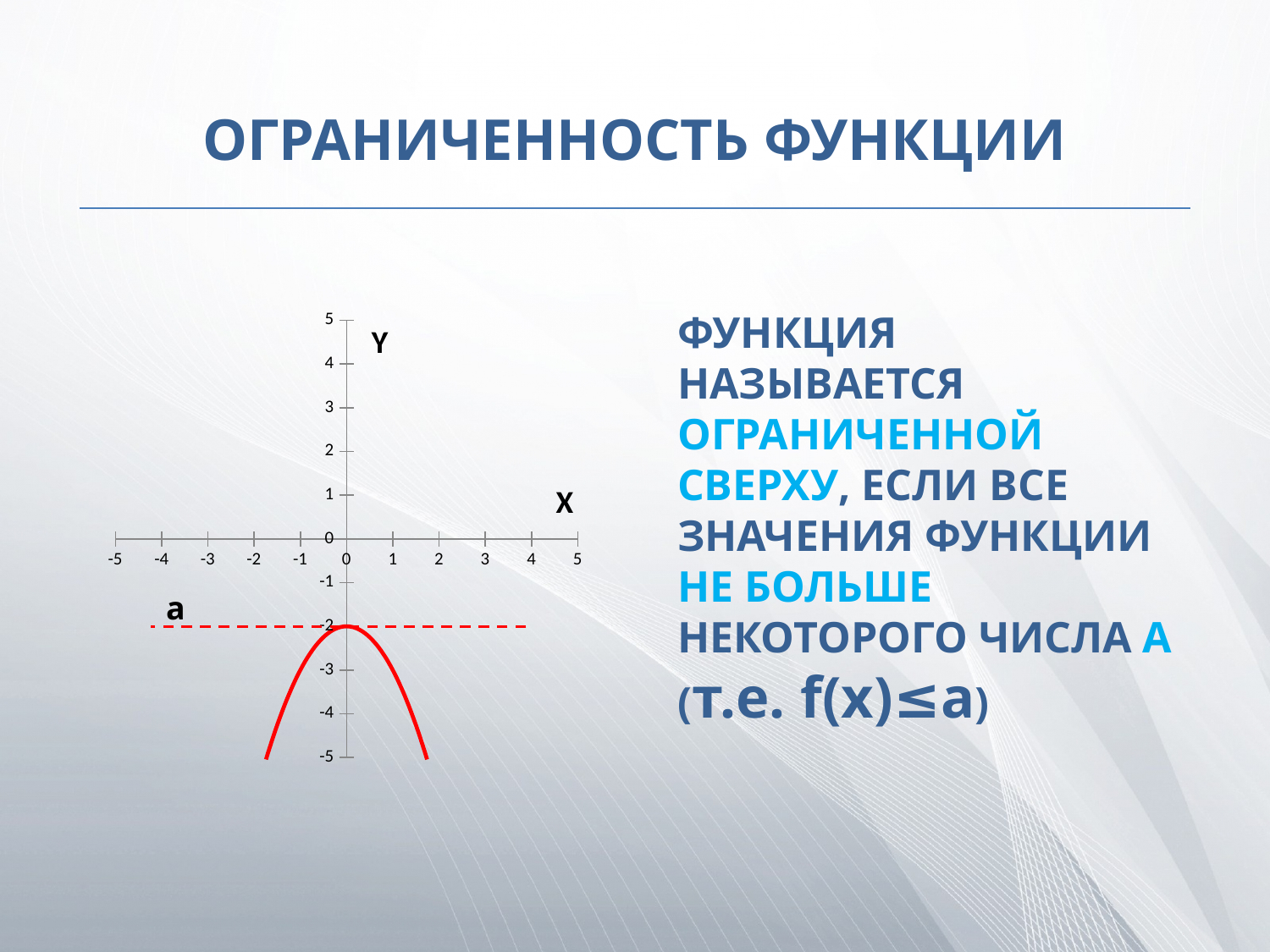
What is the lowest value labelled on the x axis? -5 How many labelled tick values are there on the x axis? 11 As x increases from -1 to 0, does the red curve rise or fall? rise Is the value of the red curve at x = 1 greater or less than -5? greater At which x value does the red curve reach its highest point? 0 As x increases from 0 to 1, does the red curve rise or fall? fall What is the highest value labelled on the y axis? 5 Which is larger: the value of the red curve at x = 0 or at x = 1? x = 0 What is the largest value the red curve reaches on the y axis? -2 Is the value of the red curve at x = 1 greater or less than -2? less At what y value is the dashed horizontal line labelled a drawn? -2 What colour is the curve of the function on the graph? red